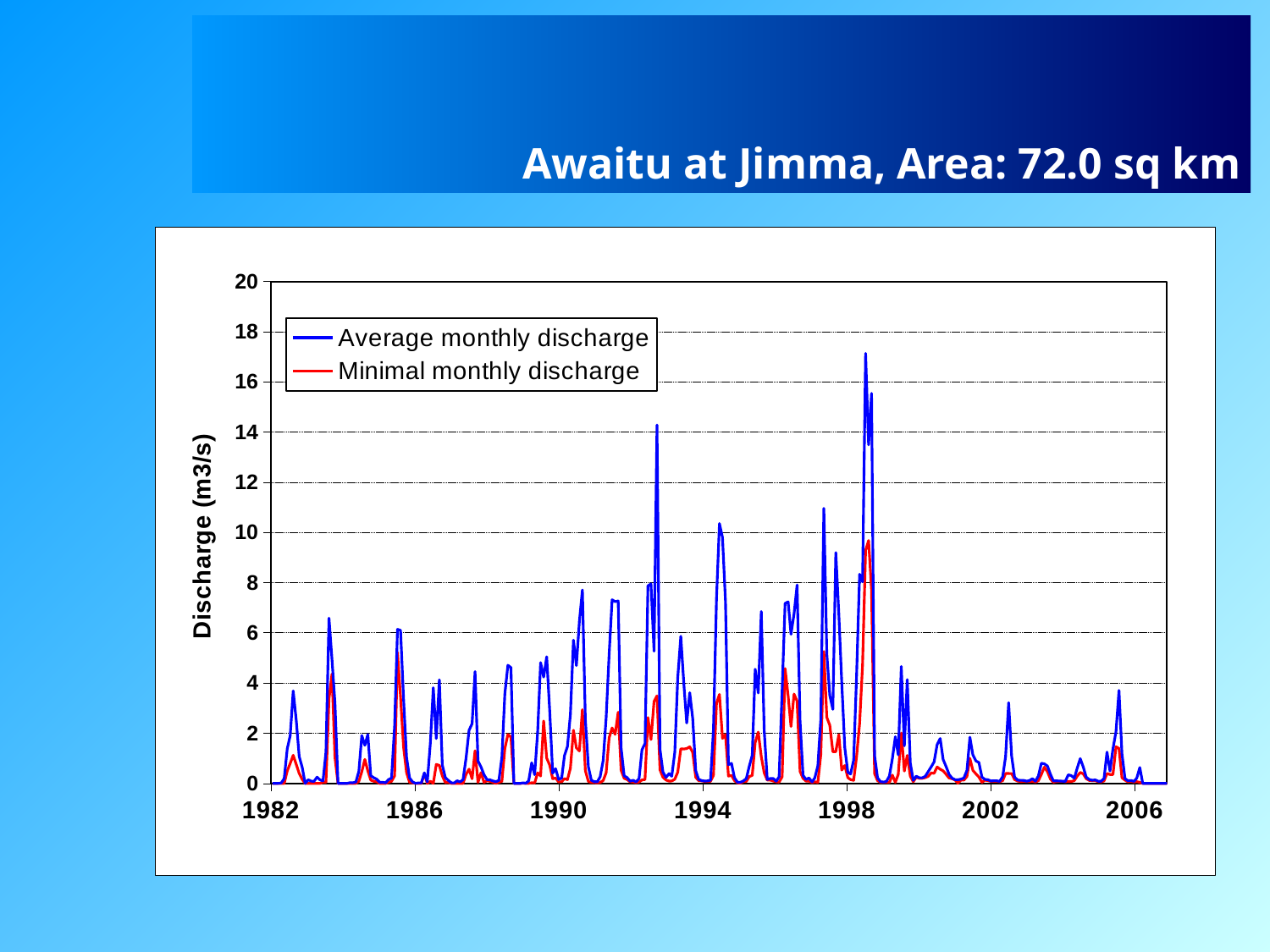
Which series reaches higher values overall, Average monthly discharge or Minimal monthly discharge? Average monthly discharge Is the highest value of Minimal monthly discharge greater or less than 8? greater Is the highest value of Minimal monthly discharge greater or less than 12? less Is the highest value of Average monthly discharge greater or less than 16? greater What is the label of the vertical axis? Discharge (m3/s) What kind of chart is shown on the slide? line chart What are the two series named in the legend? Average monthly discharge; Minimal monthly discharge Do the peaks of Average monthly discharge after 2002 rise or fall compared with the peaks in the late 1990s? fall How many series does the legend list? 2 How many year labels are shown on the horizontal axis? 7